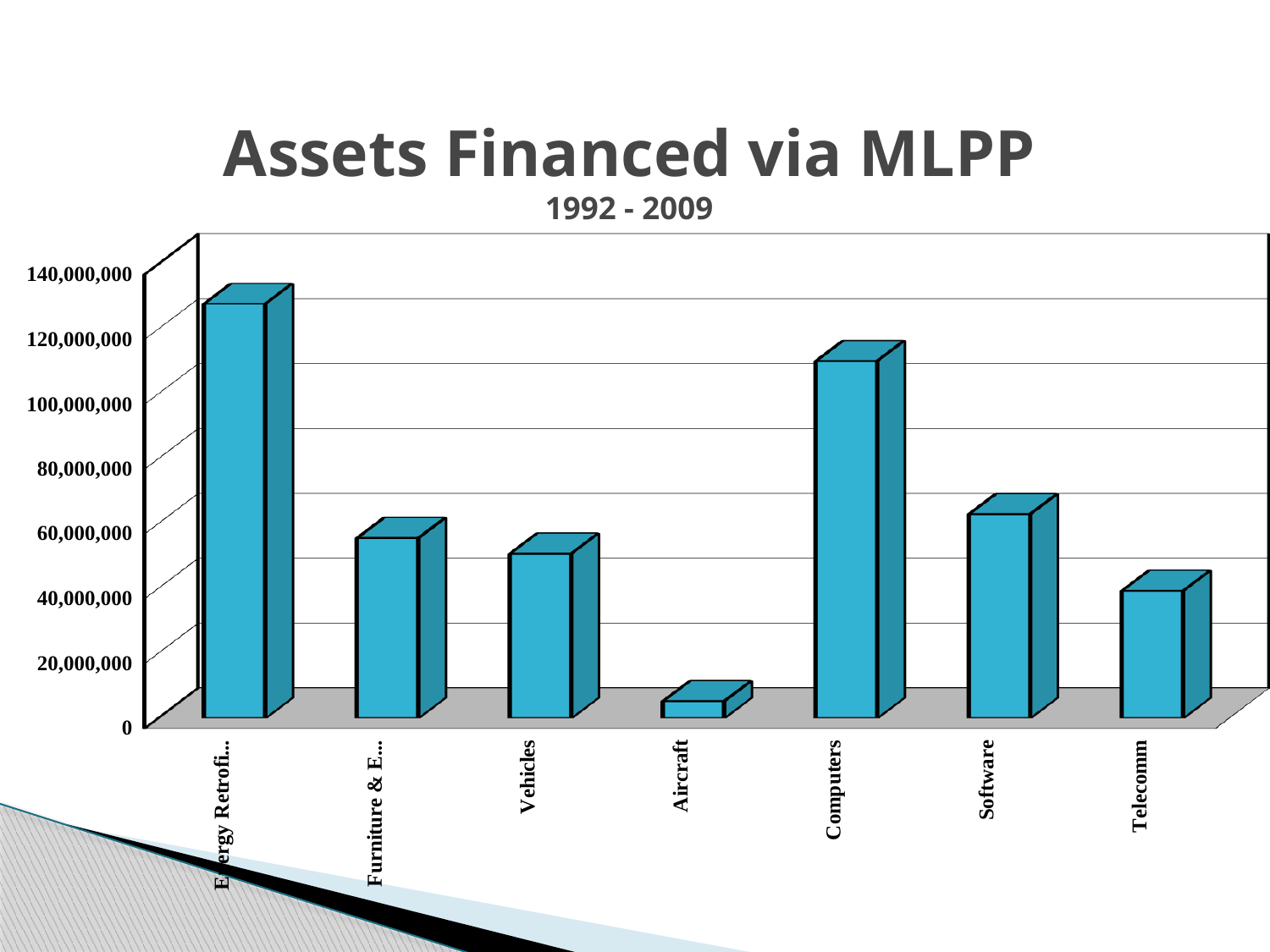
Is the value for Aircraft greater or less than 20,000,000? less Is the value for Vehicles greater or less than 60,000,000? less Which is larger, the value for Energy Retrofi... or the value for Computers? Energy Retrofi... Is the value for Energy Retrofi... greater or less than 120,000,000? greater What type of chart is shown on the slide? bar chart Which category has the highest value? Energy Retrofi... How many categories are plotted in the chart? 7 What is the title of the chart? Assets Financed via MLPP Which category has the lowest value? Aircraft Which is larger, the value for Computers or the value for Software? Computers Which is larger, the value for Vehicles or the value for Telecomm? Vehicles